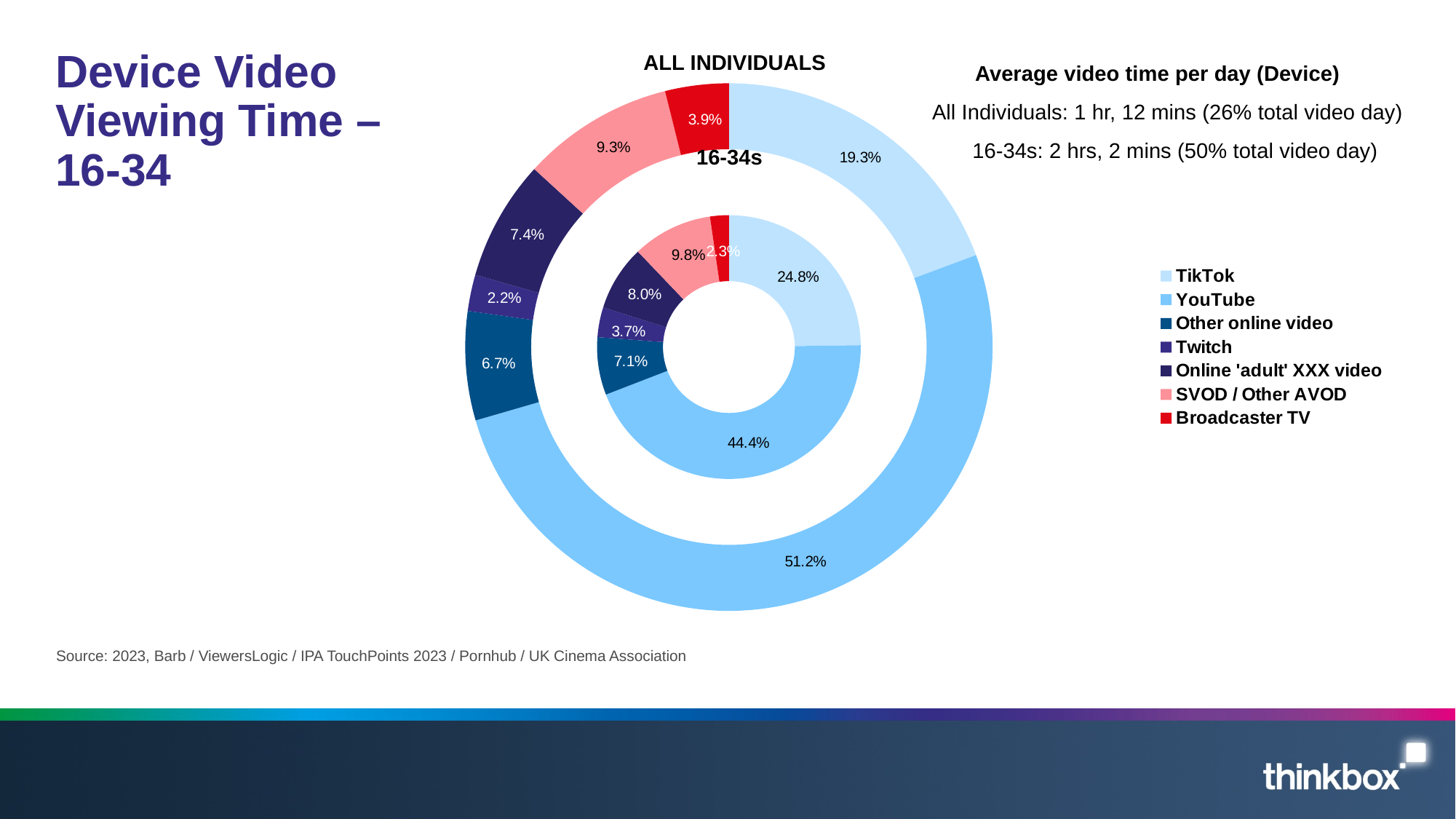
What is the difference between the TikTok share for 16-34s and the TikTok share for All Individuals? 5.5% How many categories does the legend list? 7 In the inner ring (16-34s), what share does TikTok have? 24.8% Which is larger: the Twitch share for All Individuals or the Twitch share for 16-34s? 16-34s In the outer ring (All Individuals), what share does SVOD / Other AVOD have? 9.3% Which category has the smallest share in the inner ring (16-34s)? Broadcaster TV Which category has the largest share in the outer ring (All Individuals)? YouTube Which ring of the doughnut chart represents All Individuals, the inner or the outer? Outer In the outer ring (All Individuals), what share does YouTube have? 51.2% What kind of chart is shown on the slide? Doughnut chart In the inner ring (16-34s), what share does Broadcaster TV have? 2.3% Which category has the smallest share in the outer ring (All Individuals)? Twitch